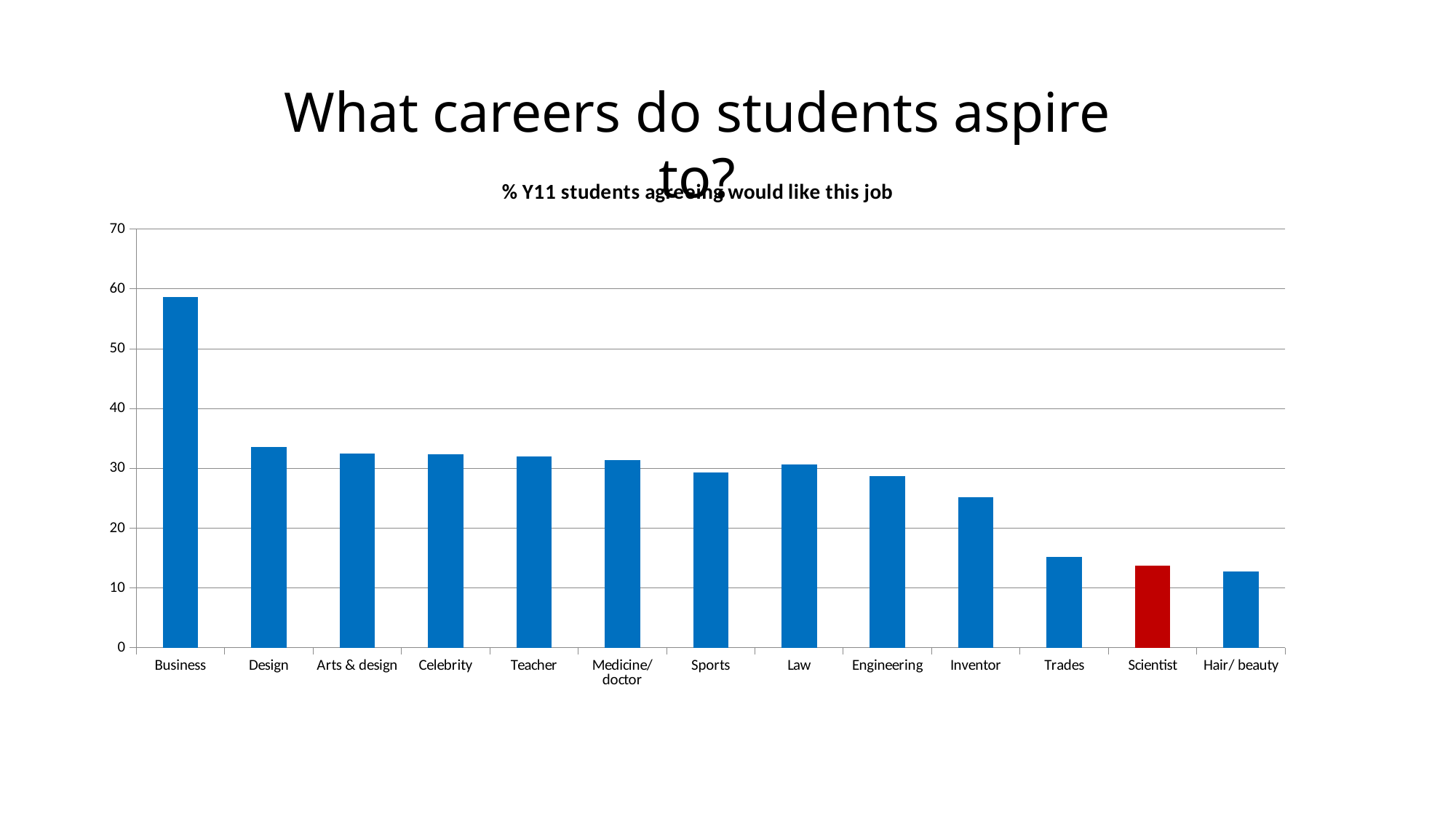
Is the value for Inventor greater or less than 20? greater Which career's bar is coloured red rather than blue? Scientist Do the values generally rise or fall moving from left to right along the x axis? fall Which career has the highest percentage of Y11 students agreeing they would like the job? Business Which is larger, the value for Business or the value for Design? Business Is the value for Business greater or less than 50? greater Is the value for Hair/ beauty greater or less than 10? greater Which is larger, the value for Inventor or the value for Trades? Inventor What kind of chart is shown on the slide? bar chart How many careers are shown on the x axis of the chart? 13